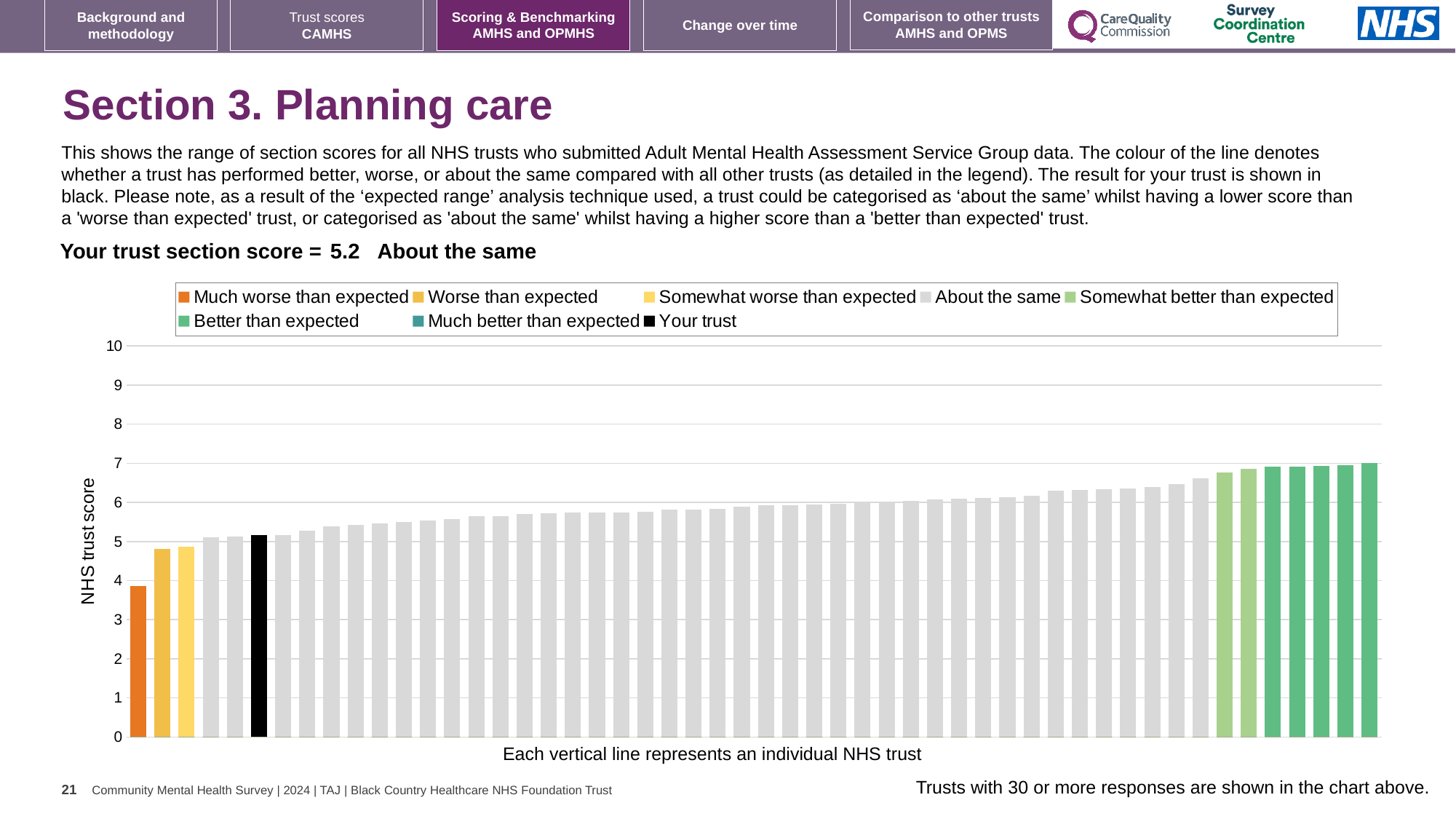
Do the bar values rise or fall from left to right along the x axis? rise What is the highest value shown on the vertical axis? 10 How many orange bars (Much worse than expected) are in the chart? 1 What colour is the bar representing your trust? black Is the value for your trust (the black bar) greater or less than 5? greater What is the section score for your trust? 5.2 Which category does your trust fall into according to the slide? About the same Is the value for the tallest bar greater or less than 6? greater Is the value for the leftmost (orange) bar greater or less than 5? less What kind of chart is shown on the slide? bar chart What is the label on the vertical axis of the chart? NHS trust score How many entries does the chart legend list? 8